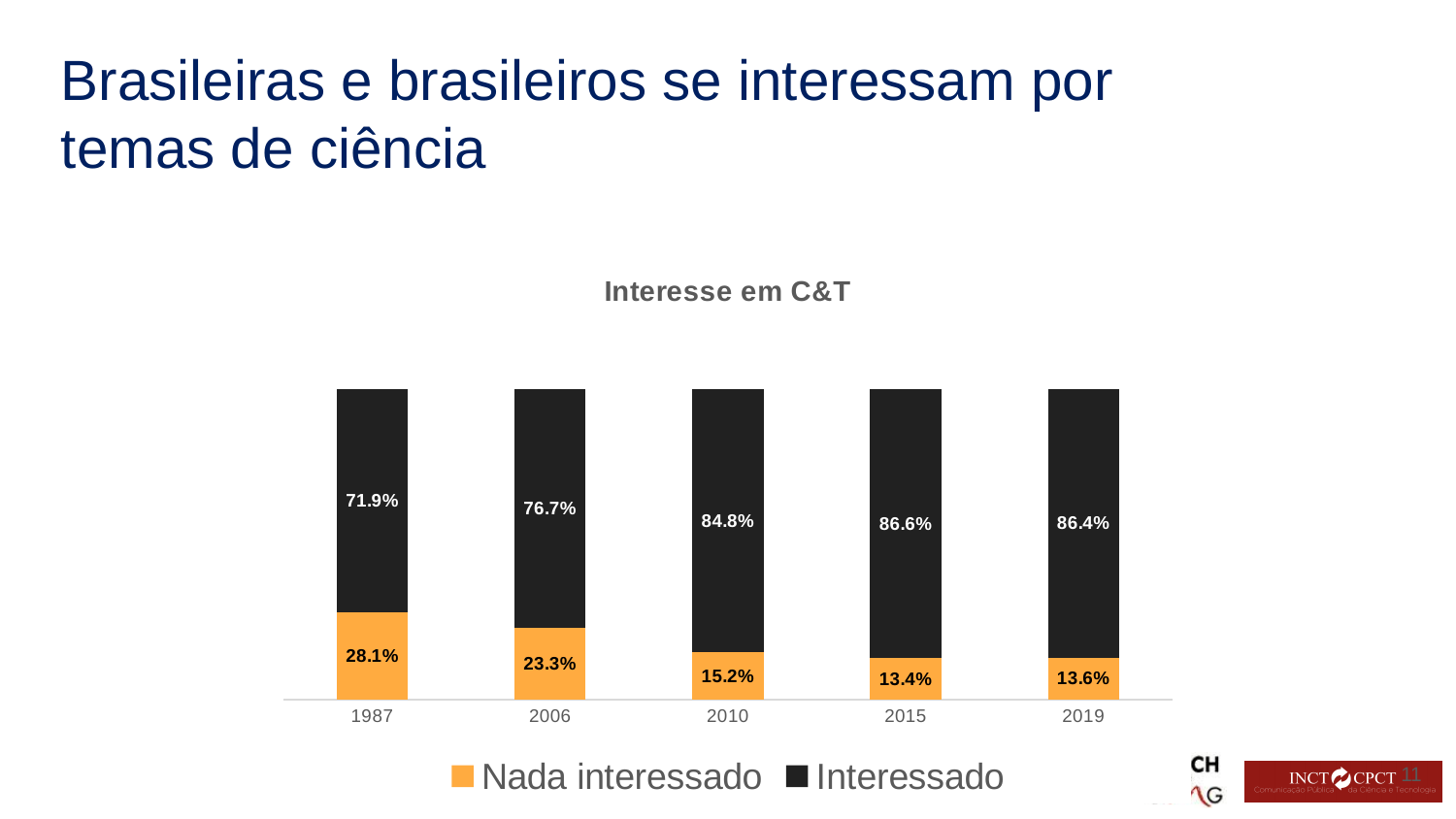
Which is larger: the 'Interessado' value in 2006 or in 2015? 2015 By how much did the 'Nada interessado' share fall from 1987 to 2019? 14.5 percentage points How many series does the legend list? 2 How many years are shown on the x axis? 5 What is the value for 'Nada interessado' in 2006? 23.3% In which year is the 'Interessado' share lowest? 1987 What type of chart is shown on the slide? Stacked bar chart Does the 'Interessado' share generally rise or fall from 1987 to 2019? Rise What is the title of the chart? Interesse em C&T What is the difference between the 'Interessado' and 'Nada interessado' values in 2019? 72.8 percentage points In which year is the 'Nada interessado' share highest? 1987 What is the value for 'Interessado' in 2010? 84.8%